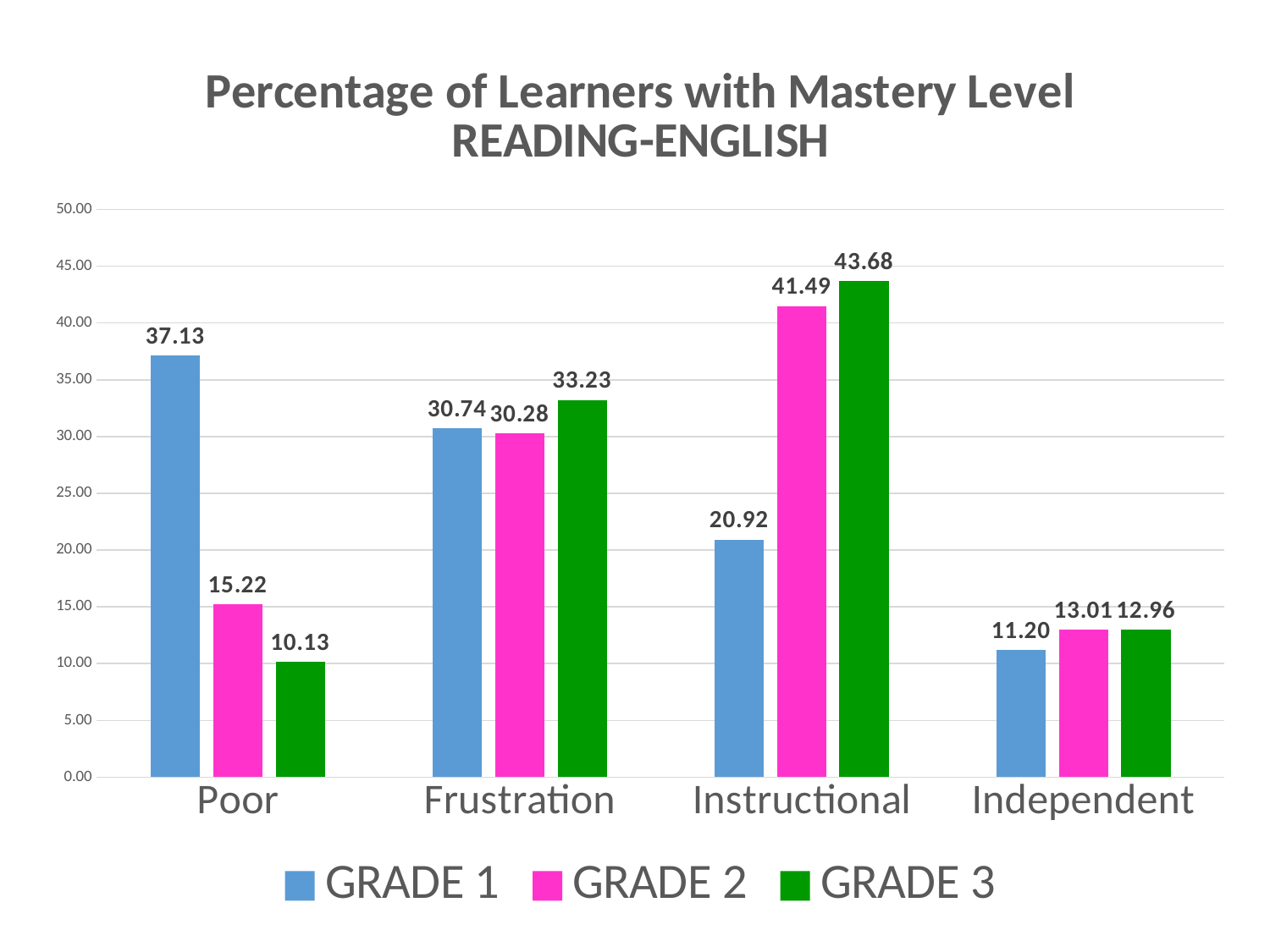
What is the difference between GRADE 3 and GRADE 1 in the Instructional category? 22.76 Is the value for GRADE 2 in the Instructional category greater or less than 40.00? greater Which category has the highest value for GRADE 2? Instructional What is the value for GRADE 2 in the Independent category? 13.01 Which is larger in the Poor category, GRADE 1 or GRADE 2? GRADE 1 What is the value for GRADE 3 in the Instructional category? 43.68 What is the value for GRADE 1 in the Poor category? 37.13 Which category has the lowest value for GRADE 3? Poor What colour represents GRADE 2 in the chart? Pink How many series does the legend list? 3 How many categories are shown on the x axis? 4 What kind of chart is shown on the slide? Bar chart